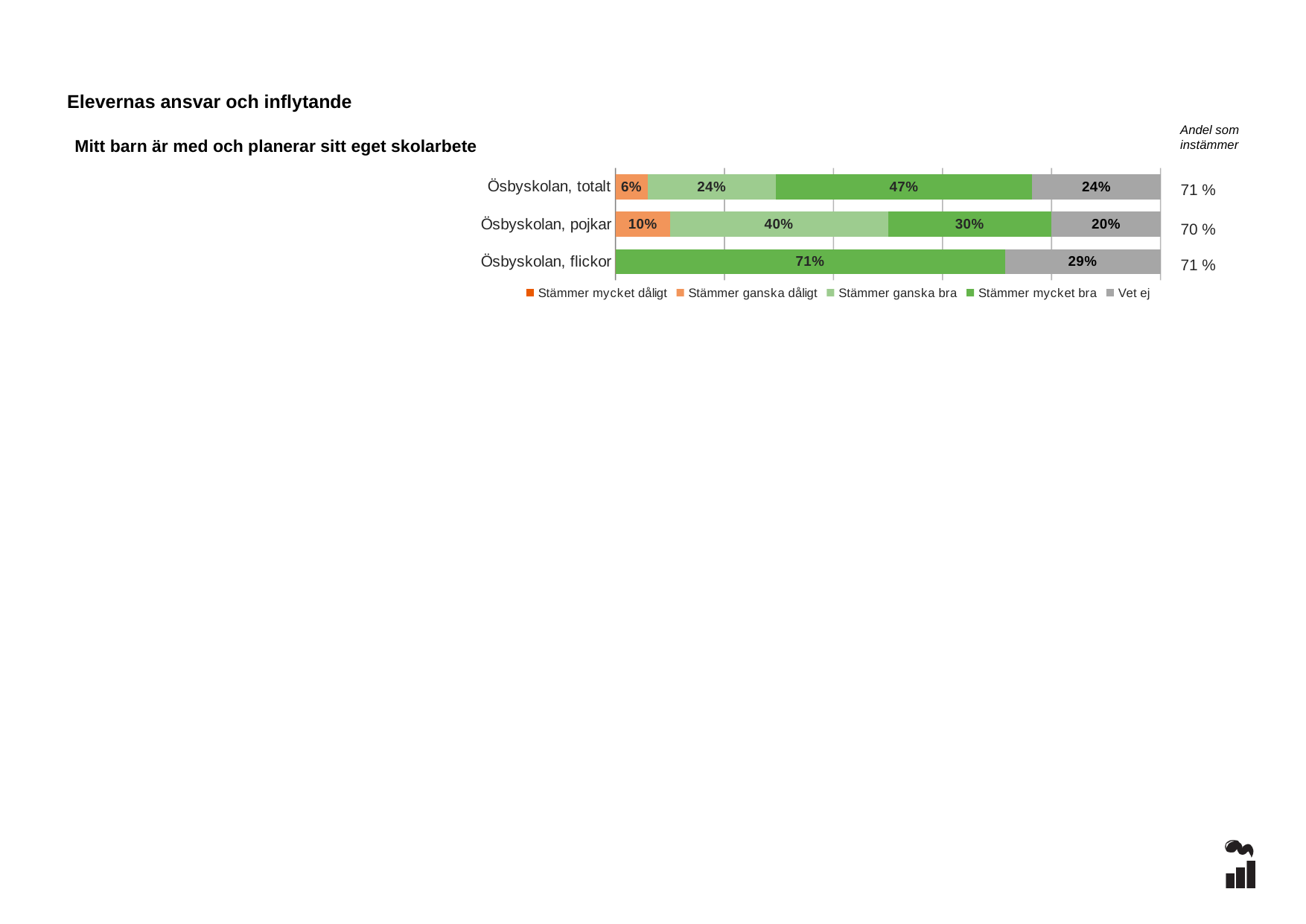
What is the value for "Stämmer mycket bra" for Ösbyskolan, totalt? 47% What is the value for "Vet ej" for Ösbyskolan, flickor? 29% How many categories are shown on the chart? 3 What kind of chart is shown on the slide? Stacked bar chart Which category has the highest value for "Stämmer mycket bra"? Ösbyskolan, flickor Which is larger: "Stämmer ganska bra" for Ösbyskolan, pojkar or "Stämmer ganska bra" for Ösbyskolan, totalt? Ösbyskolan, pojkar What is the value for "Stämmer ganska dåligt" for Ösbyskolan, pojkar? 10% How many series does the legend list? 5 What is the "Andel som instämmer" value shown for Ösbyskolan, pojkar? 70 % What is the value for "Stämmer ganska bra" for Ösbyskolan, pojkar? 40% What is the difference between the "Stämmer mycket bra" values for Ösbyskolan, flickor and Ösbyskolan, pojkar? 41% Which category has the lowest value for "Vet ej"? Ösbyskolan, pojkar